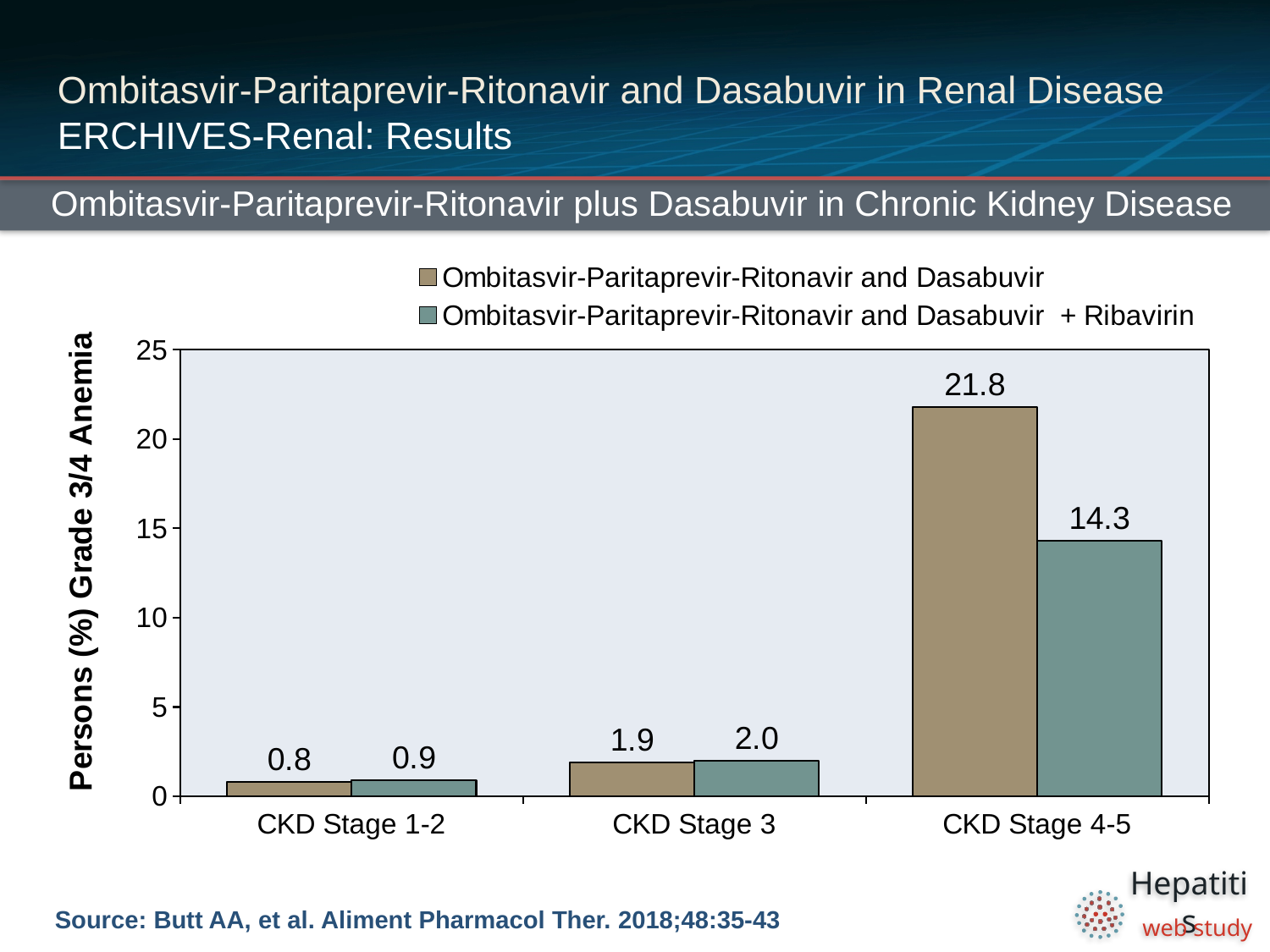
How many CKD stage categories are shown on the x axis? 3 What is the value for CKD Stage 3 in the Ombitasvir-Paritaprevir-Ritonavir and Dasabuvir + Ribavirin series? 2.0 What is the value for CKD Stage 1-2 in the Ombitasvir-Paritaprevir-Ritonavir and Dasabuvir series? 0.8 Which CKD stage has the highest value in the Ombitasvir-Paritaprevir-Ritonavir and Dasabuvir + Ribavirin series? CKD Stage 4-5 For CKD Stage 4-5, which series has the larger value? Ombitasvir-Paritaprevir-Ritonavir and Dasabuvir What is the label of the y axis? Persons (%) Grade 3/4 Anemia What is the value for CKD Stage 4-5 in the Ombitasvir-Paritaprevir-Ritonavir and Dasabuvir series? 21.8 Which CKD stage has the lowest value in the Ombitasvir-Paritaprevir-Ritonavir and Dasabuvir series? CKD Stage 1-2 What kind of chart is shown on the slide? Bar chart What is the difference between the two series' values for CKD Stage 4-5? 7.5 Is the value for CKD Stage 4-5 in the Ombitasvir-Paritaprevir-Ritonavir and Dasabuvir series greater or less than 20? greater How many series does the legend list? 2